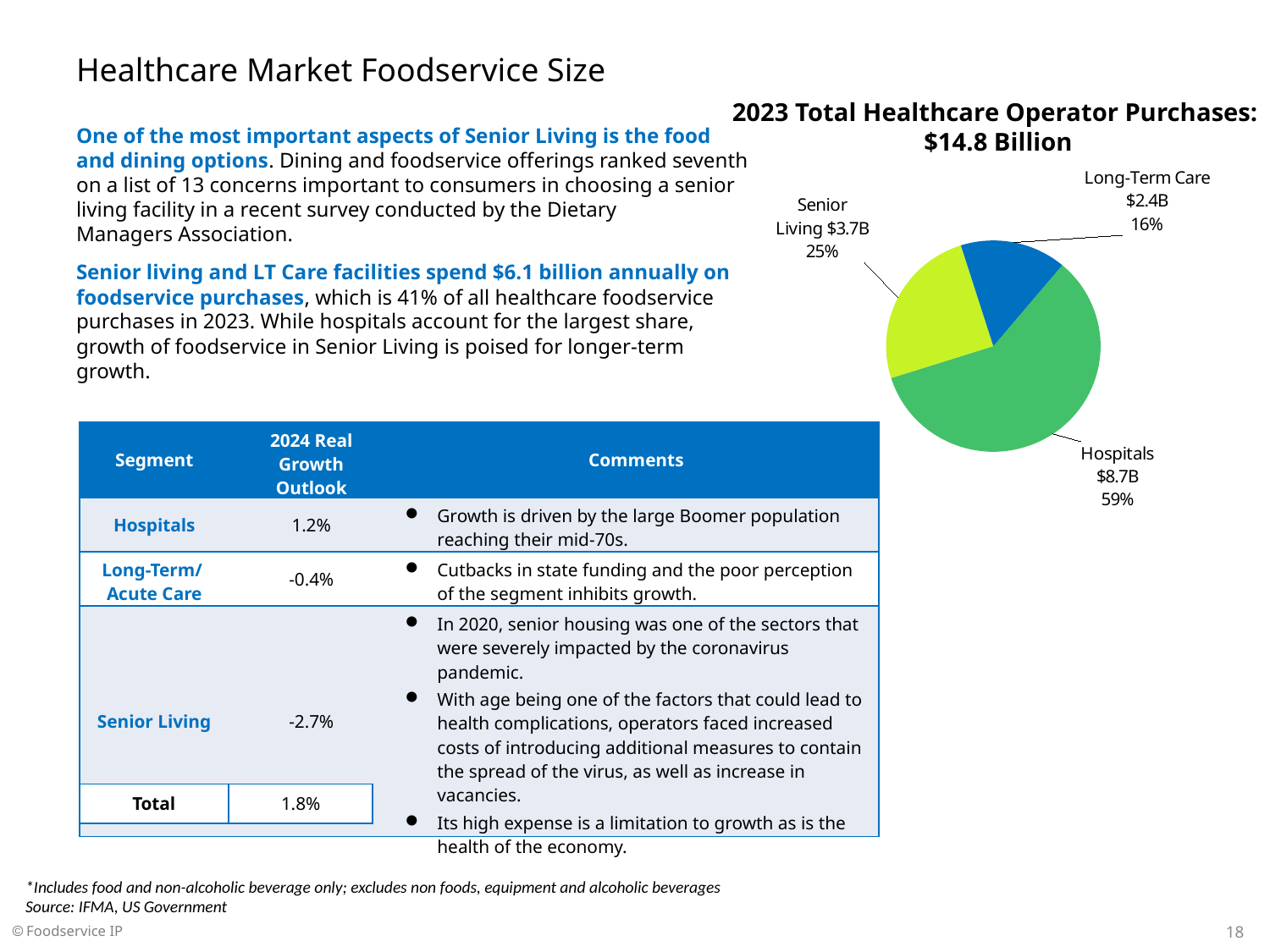
Which segment has the smallest slice in the pie chart? Long-Term Care What is the title of the pie chart? 2023 Total Healthcare Operator Purchases: $14.8 Billion What is the value for Long-Term Care in the pie chart? $2.4B Which segment has the largest slice in the pie chart? Hospitals What type of chart is shown on the slide? pie chart How many slices does the pie chart have? 3 What is the value for Senior Living in the pie chart? $3.7B What share of the pie does Long-Term Care represent? 16% Which is larger in the pie chart, Senior Living or Long-Term Care? Senior Living What share of the pie does Hospitals represent? 59% What is the difference in percentage share between Senior Living and Long-Term Care? 9% What is the value for Hospitals in the pie chart? $8.7B